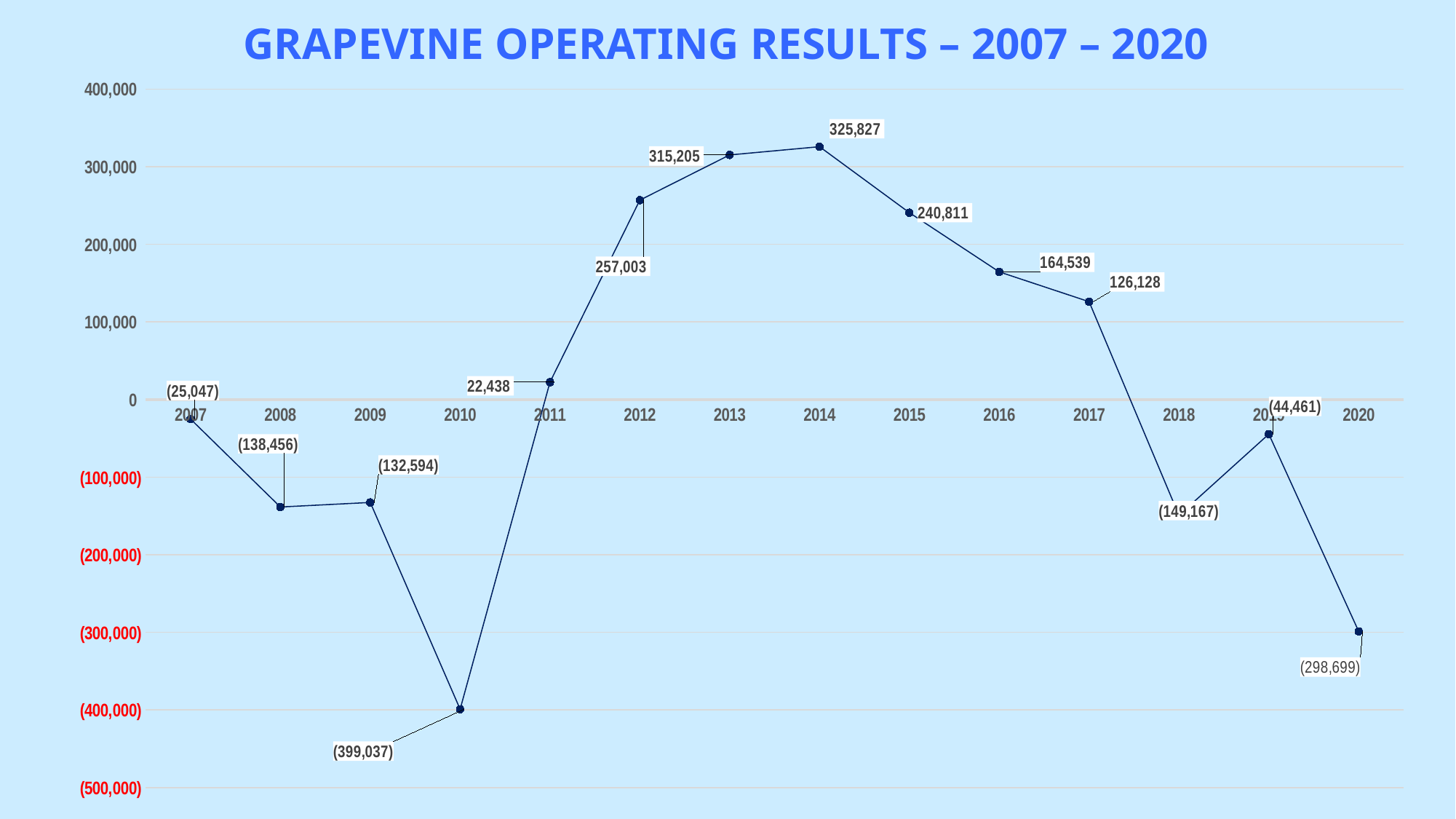
What kind of chart is shown on the slide? Line chart What is the operating result shown for 2014? 325,827 Which year has the larger value, 2015 or 2016? 2015 What is the value labelled for 2011? 22,438 How many years are plotted on the chart? 14 Do the values rise or fall from 2014 to 2017? Fall What is the value shown for 2020? (298,699) Is the value for 2012 greater or less than 200,000? greater Which year has the highest operating result? 2014 Which year has the lowest operating result? 2010 What value is labelled for 2010? (399,037) What is the difference between the values for 2014 and 2013? 10,622